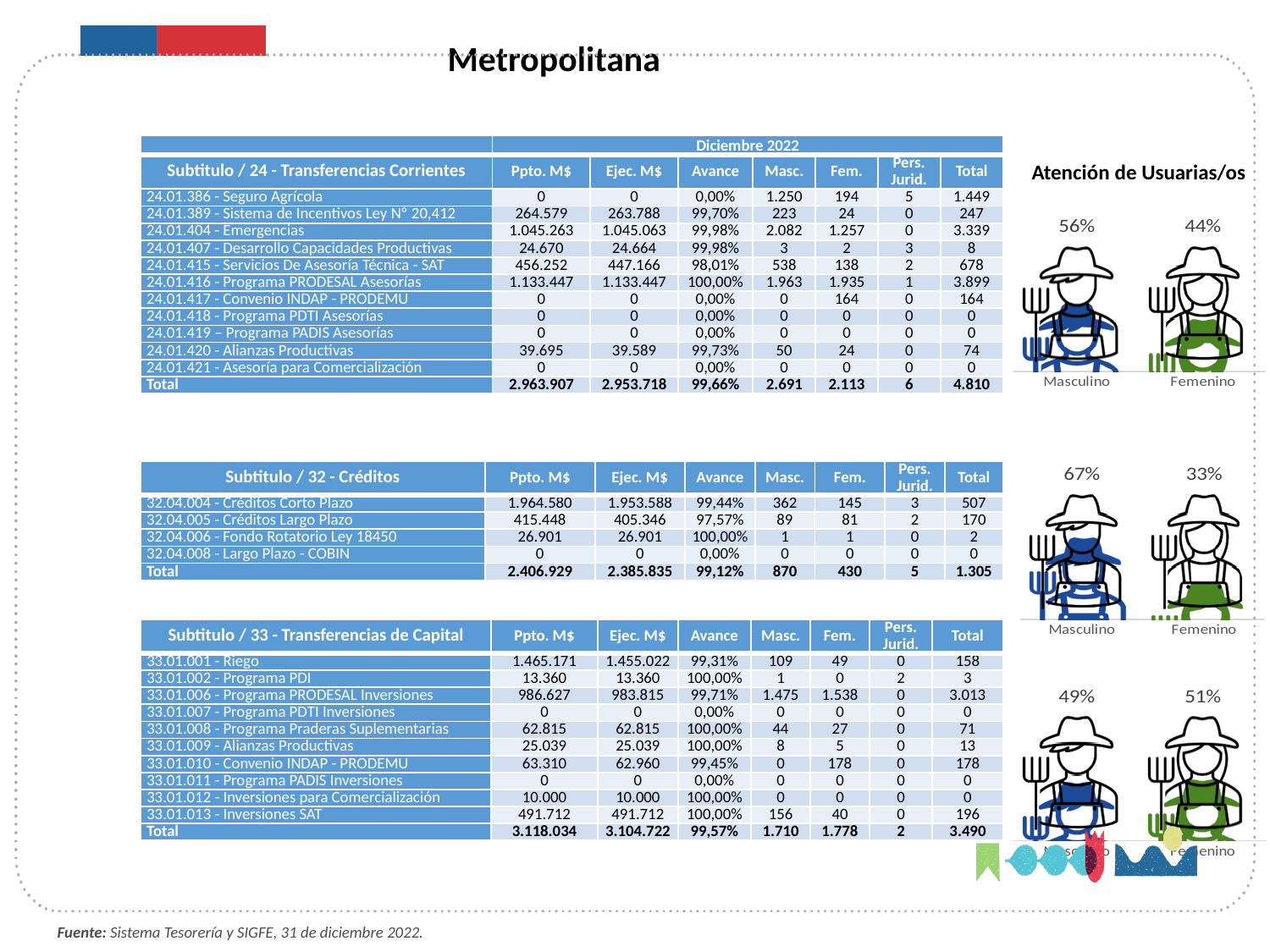
In the top 'Atención de Usuarias/os' pictogram chart (next to Subtítulo 24), what percentage is shown for Masculino? 56% In the bottom pictogram chart (next to Subtítulo 33 - Transferencias de Capital), which category has the higher percentage, Masculino or Femenino? Femenino In the bottom pictogram chart (next to Subtítulo 33 - Transferencias de Capital), what percentage is shown for Femenino? 51% In the middle pictogram chart (next to Subtítulo 32 - Créditos), what percentage is shown for Masculino? 67% In the middle pictogram chart (next to Subtítulo 32 - Créditos), what is the difference in percentage points between Masculino and Femenino? 34 What is the title shown above the top pictogram chart on the right side of the slide? Atención de Usuarias/os In the top 'Atención de Usuarias/os' pictogram chart, what is the difference in percentage points between Masculino and Femenino? 12 How many categories does each pictogram chart on the right side of the slide show? 2 In the middle pictogram chart (next to Subtítulo 32 - Créditos), what percentage is shown for Femenino? 33% In the middle pictogram chart (next to Subtítulo 32 - Créditos), which category has the higher percentage, Masculino or Femenino? Masculino In the top 'Atención de Usuarias/os' pictogram chart (next to Subtítulo 24), what percentage is shown for Femenino? 44% In the bottom pictogram chart (next to Subtítulo 33 - Transferencias de Capital), what percentage is shown for Masculino? 49%